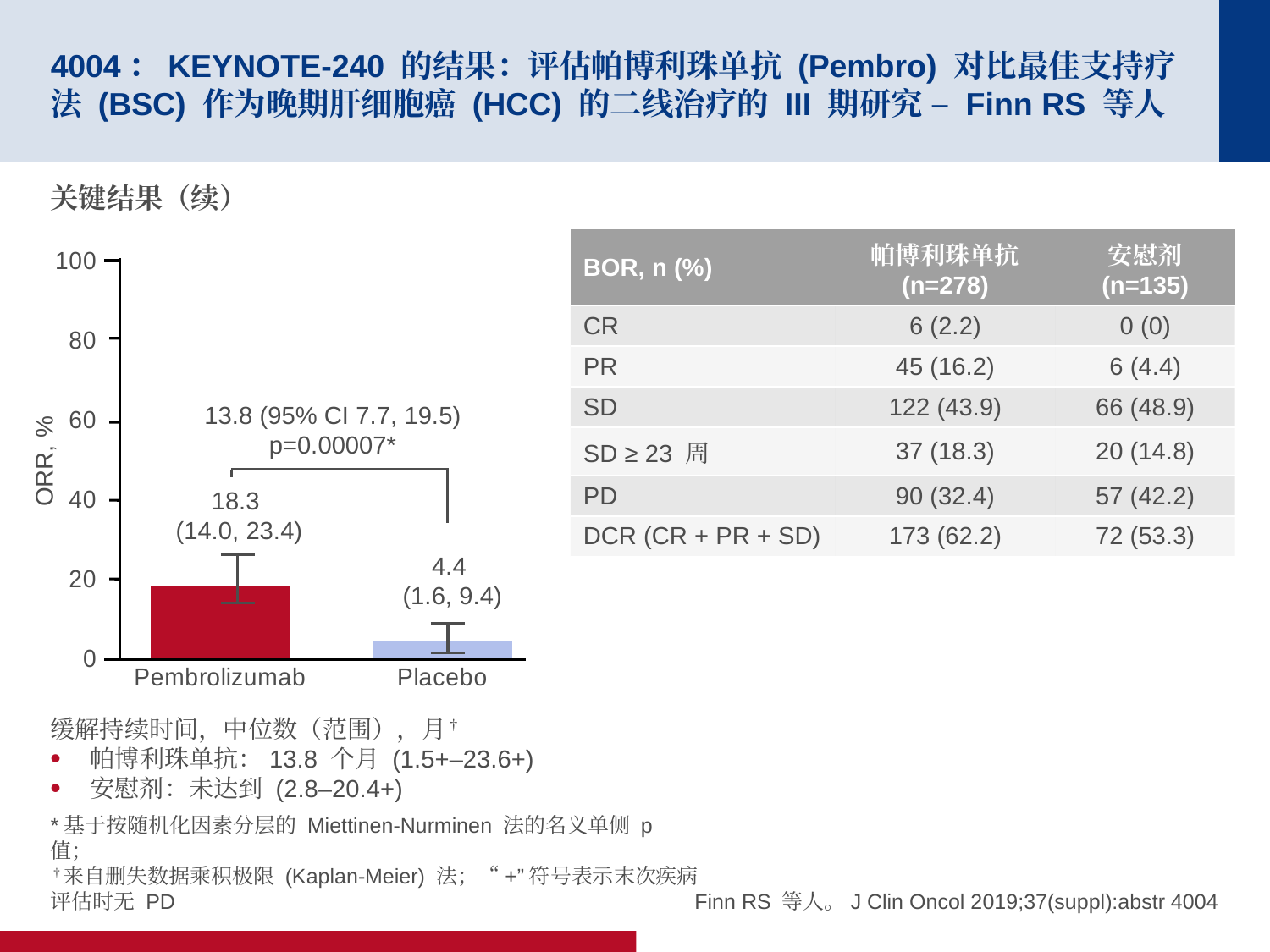
What is the difference in ORR, % between Pembrolizumab and Placebo? 13.8 How many groups are plotted on the bar chart? 2 Which group has the lower ORR, %? Placebo Is the ORR, % for Pembrolizumab greater or less than 20? less What kind of chart is shown on the slide? Bar chart What is the 95% confidence interval shown for the Pembrolizumab ORR? (14.0, 23.4) What is the label of the y axis of the bar chart? ORR, % What is the ORR, % value for Pembrolizumab? 18.3 Which group has the higher ORR, %? Pembrolizumab Is the ORR, % for Placebo greater or less than 20? less What is the 95% confidence interval shown for the Placebo ORR? (1.6, 9.4) What is the ORR, % value for Placebo? 4.4